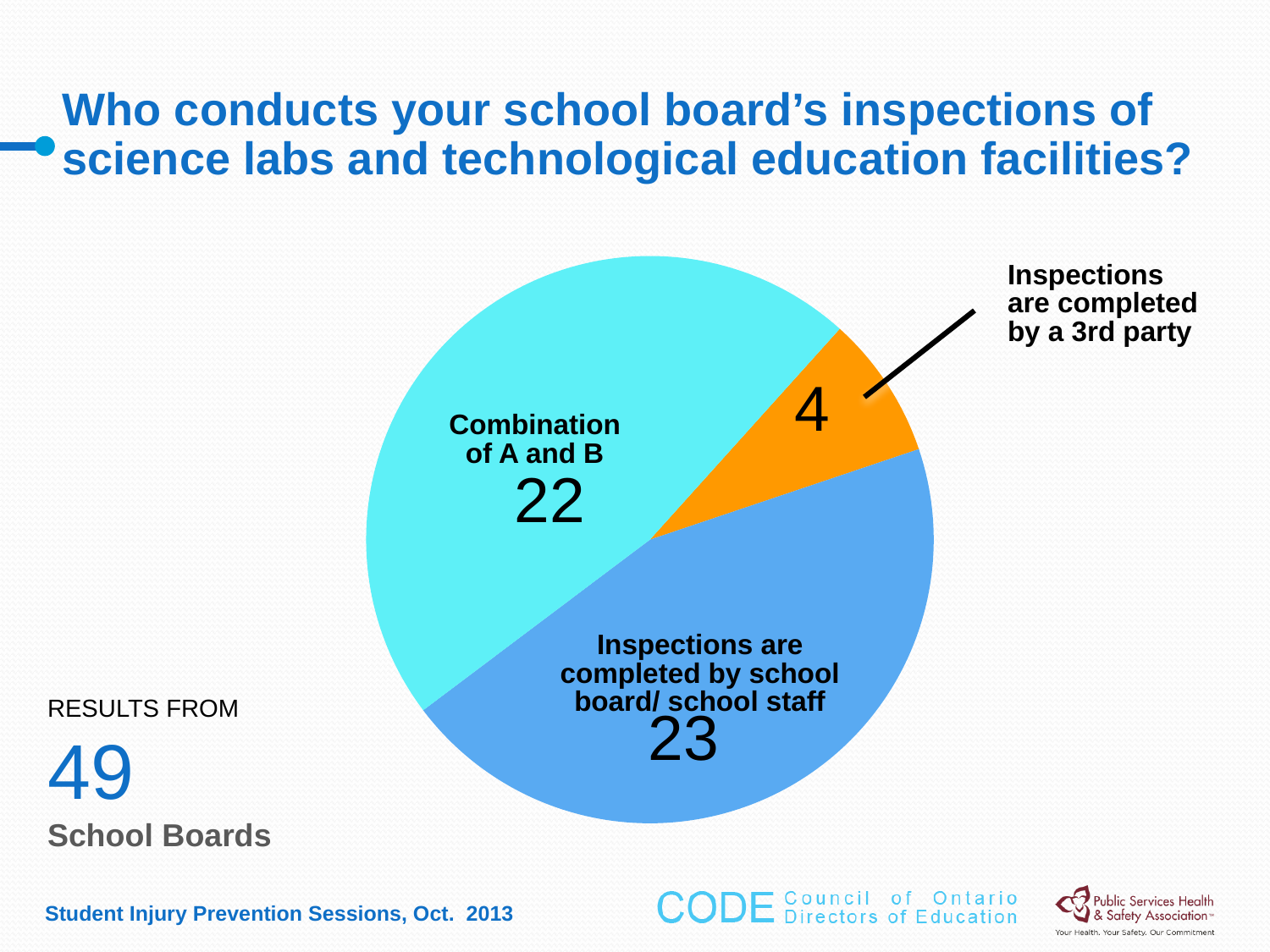
Which category has the smallest slice of the pie? Inspections are completed by a 3rd party What is the value for 'Combination of A and B'? 22 What is the value for 'Inspections are completed by a 3rd party'? 4 Which category has the largest slice of the pie? Inspections are completed by school board/ school staff What is the value for 'Inspections are completed by school board/ school staff'? 23 What is the difference between the value for 'Combination of A and B' and the value for 'Inspections are completed by a 3rd party'? 18 What is the total of all three slices in the pie chart? 49 What colour is the slice for 'Inspections are completed by a 3rd party'? orange What kind of chart is shown on the slide? pie chart What is the difference between the value for 'Inspections are completed by school board/ school staff' and the value for 'Combination of A and B'? 1 How many slices does the pie chart have? 3 Which is larger: the value for 'Combination of A and B' or the value for 'Inspections are completed by a 3rd party'? Combination of A and B